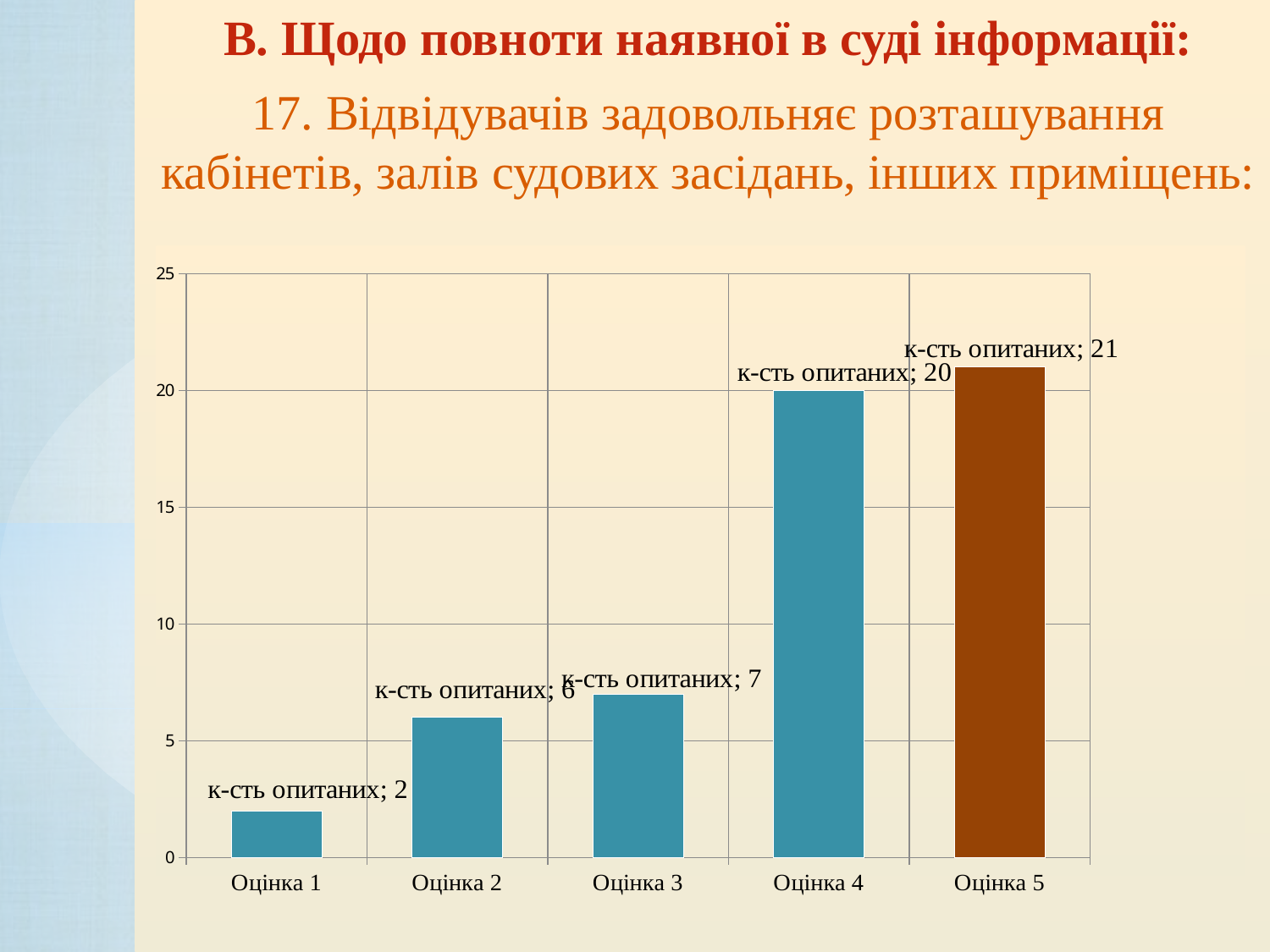
Is the value for Оцінка 2 greater or less than 10? less What is the value for Оцінка 3? 7 What is the value for Оцінка 1? 2 Which category has the lowest value? Оцінка 1 What is the difference between the values for Оцінка 5 and Оцінка 4? 1 Which category has the highest value? Оцінка 5 What is the difference between the values for Оцінка 4 and Оцінка 3? 13 How many categories are shown on the x axis? 5 Which is larger, the value for Оцінка 2 or the value for Оцінка 4? Оцінка 4 What kind of chart is shown on the slide? bar chart What is the value for Оцінка 4? 20 Do the values rise or fall from Оцінка 1 to Оцінка 5? rise